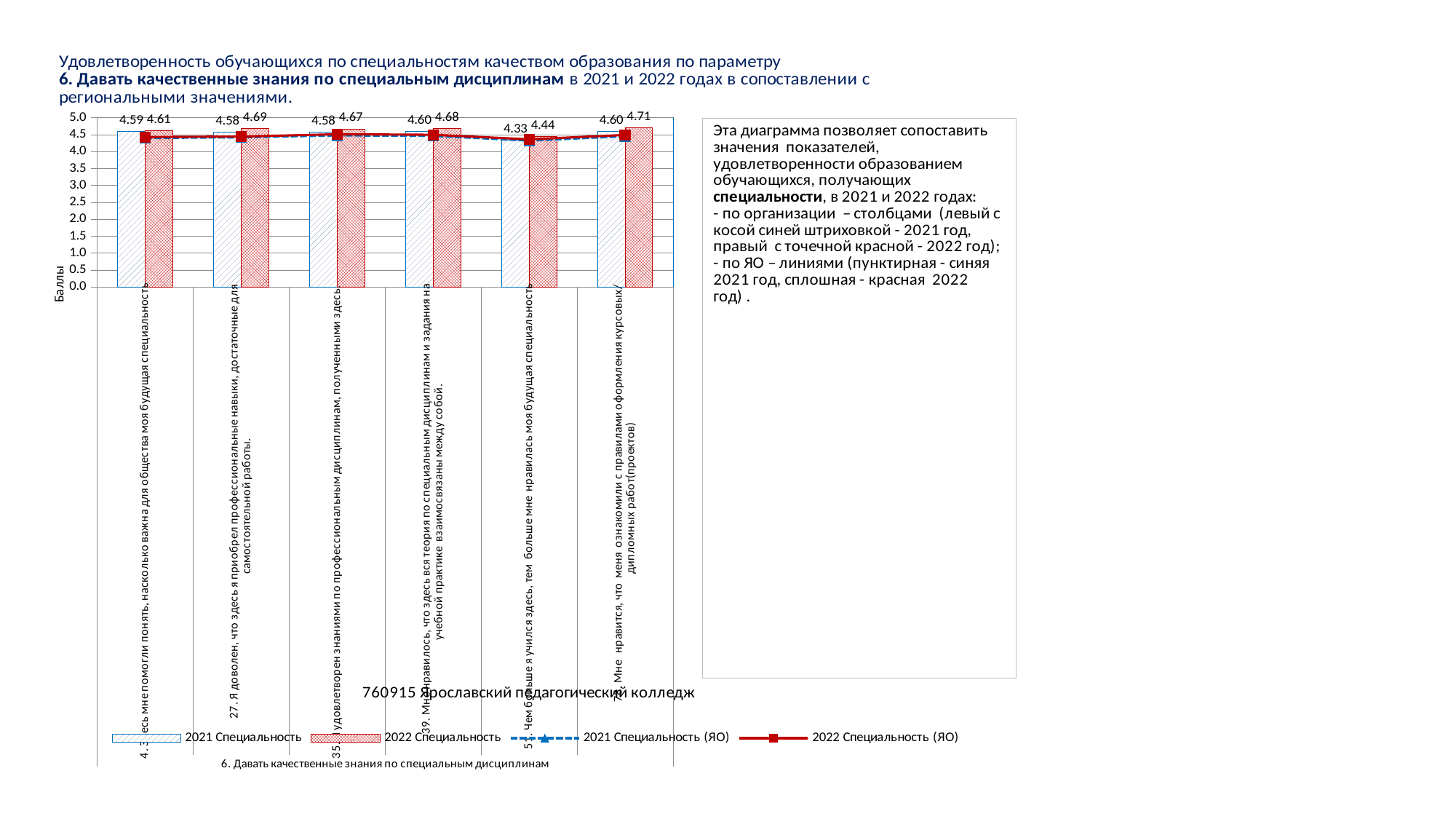
What is the label of the vertical axis of the chart? Баллы What is the value of the 2021 Специальность bar for the last category (Мне нравится, что меня ознакомили с правилами оформления курсовых/дипломных работ)? 4.60 What is the value of the 2021 Специальность bar for category 27 (Я доволен, что здесь я приобрел профессиональные навыки, достаточные для самостоятельной работы)? 4.58 Which category has the highest 2022 Специальность bar value? The last category (Мне нравится, что меня ознакомили с правилами оформления курсовых/дипломных работ), with 4.71 For category 27, which bar is larger: 2021 Специальность or 2022 Специальность? 2022 Специальность What is the value of the 2022 Специальность bar for category 39 (Мне нравилось, что здесь вся теория по специальным дисциплинам и задания на учебной практике взаимосвязаны между собой)? 4.68 What is the value of the 2022 Специальность bar for category 27 (Я доволен, что здесь я приобрел профессиональные навыки, достаточные для самостоятельной работы)? 4.69 Is the 2021 Специальность bar value for the fifth category greater or less than 4.0? greater How many categories are shown on the x axis of the chart? 6 How many series does the chart legend list? 4 What is the difference between the 2022 and 2021 Специальность bar values for the fifth category (4.44 and 4.33)? 0.11 Which category has the lowest 2021 Специальность bar value? The fifth category (51), with 4.33